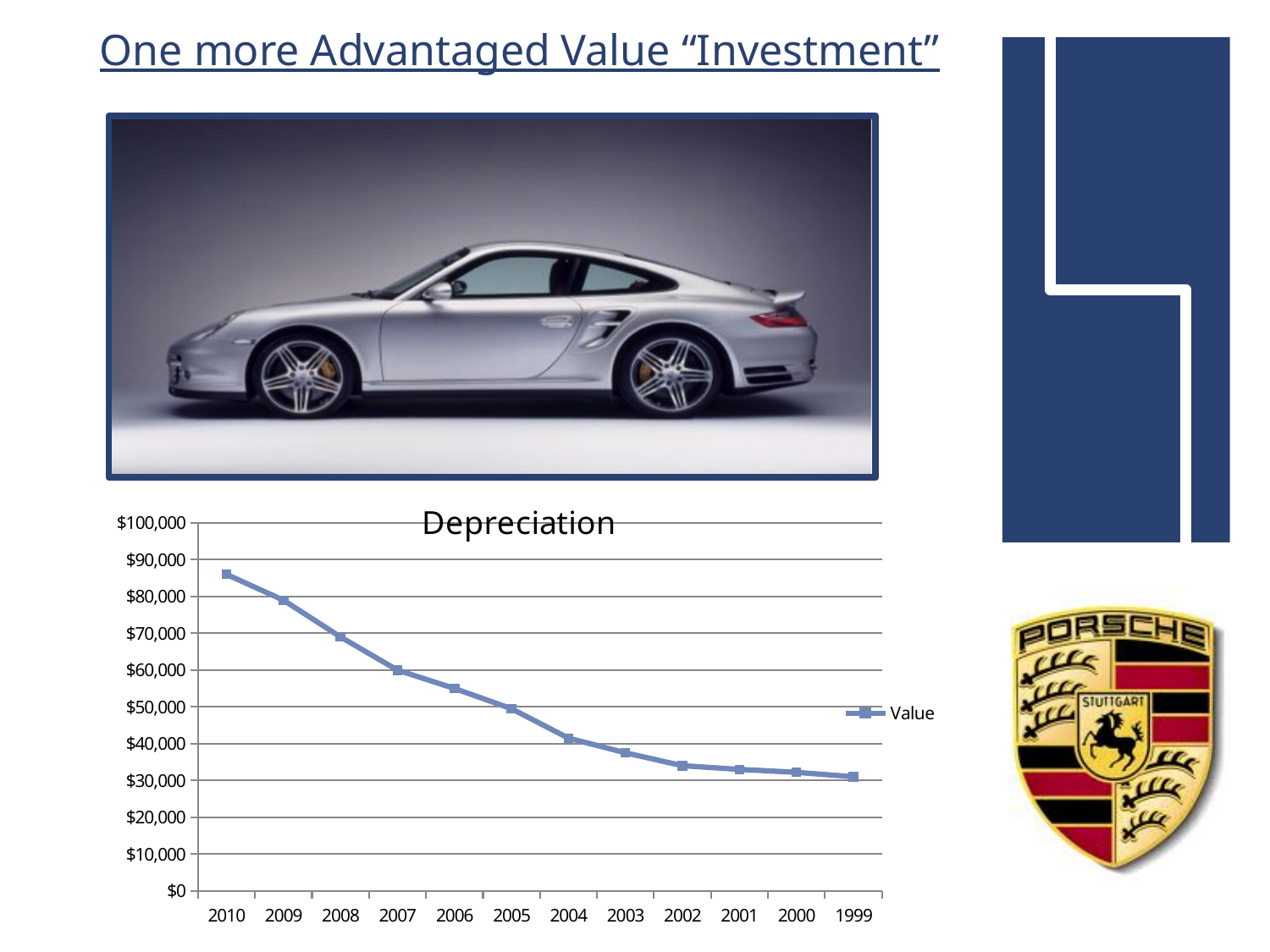
Which is larger, the value for 2007 or the value for 2002? 2007 Do the values rise or fall moving from 2010 to 1999 along the x axis? fall What kind of chart is shown on the slide? line chart Which year has the highest value? 2010 What is the title of the chart? Depreciation Is the value for 2010 greater or less than $80,000? greater How many series does the chart legend list? 1 Is the value for 2006 greater or less than $50,000? greater Is the value for 2003 greater or less than $40,000? less What is the name of the series shown in the legend? Value How many years are plotted along the x axis? 12